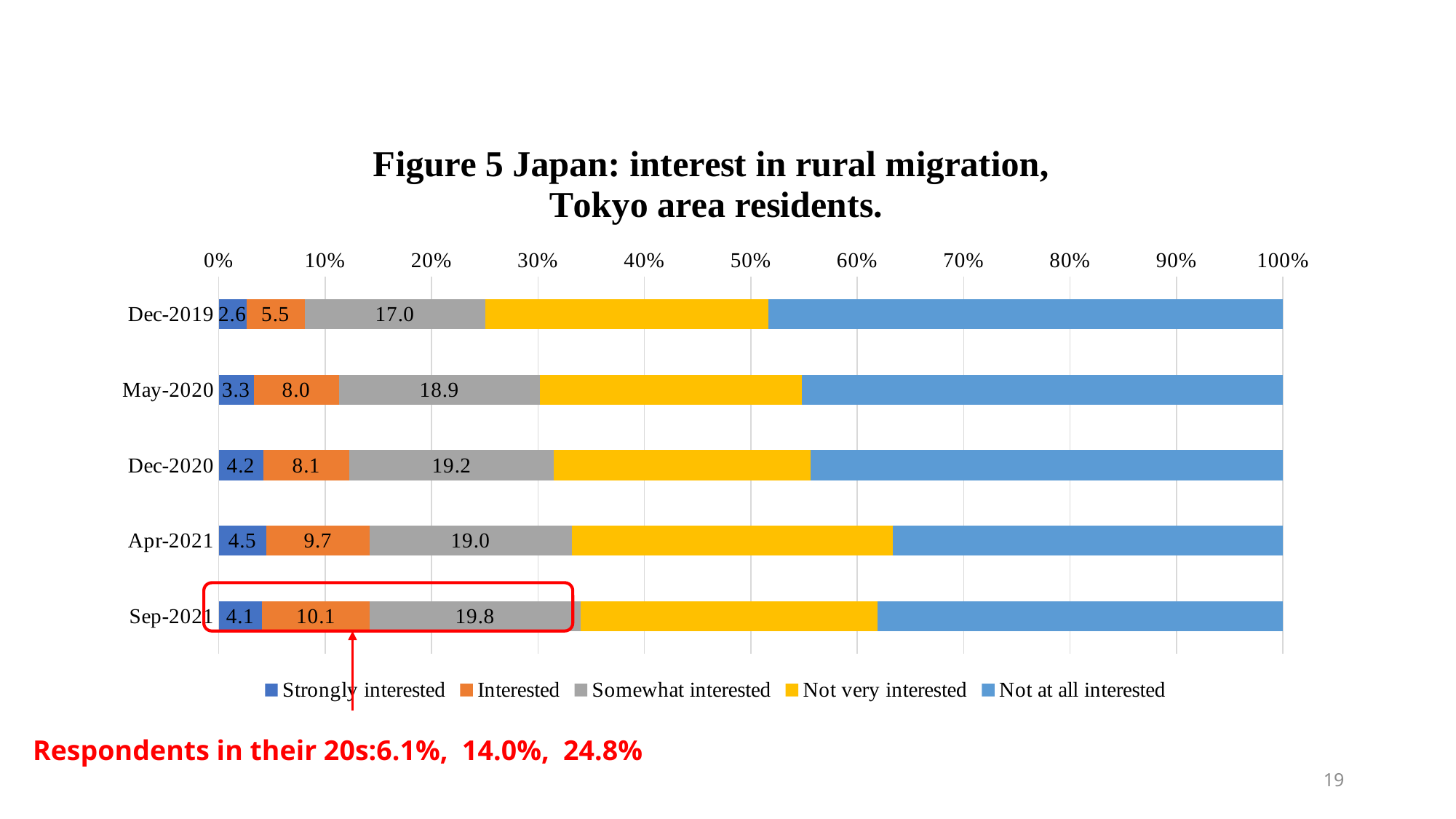
What kind of chart is shown on the slide? Stacked bar chart What is the difference between the Interested values for Sep-2021 and Dec-2019? 4.6 Which is larger, the Somewhat interested value for Dec-2020 or for Apr-2021? Dec-2020 How many series does the legend list? 5 What is the value for Strongly interested in Dec-2019? 2.6 What is the value for Interested in Sep-2021? 10.1 Which survey date has the highest value for Strongly interested? Apr-2021 Does the Interested value rise or fall from Dec-2019 to Sep-2021? Rise Is the value for Not at all interested in Dec-2019 greater or less than 40%? greater How many survey dates are shown on the chart? 5 What is the value for Somewhat interested in May-2020? 18.9 Which survey date has the lowest value for Interested? Dec-2019